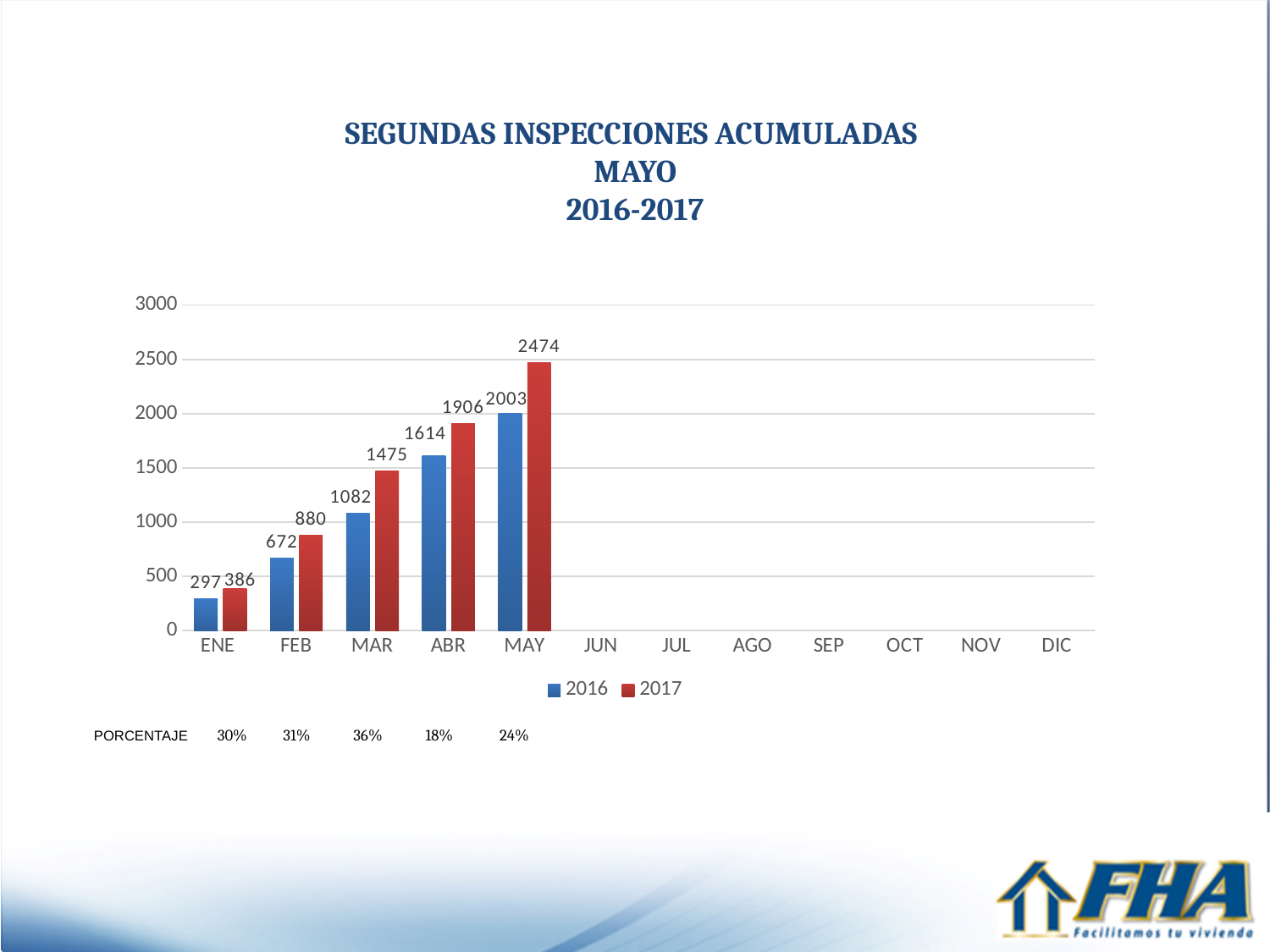
What is the difference between the 2017 and 2016 values in ABR? 292 Do the 2017 values rise or fall from ENE to MAY? rise How many series does the legend list? 2 What is the value for 2017 in MAY? 2474 Which is larger in ENE, the 2016 value or the 2017 value? 2017 What kind of chart is shown on the slide? bar chart Is the value for 2016 in MAY greater or less than 2000? greater How many month categories are shown on the x axis? 12 What is the value for 2016 in MAR? 1082 Which month has the lowest value for the 2016 series among the months with bars? ENE Which month has the highest value for the 2017 series? MAY What is the value for 2017 in FEB? 880